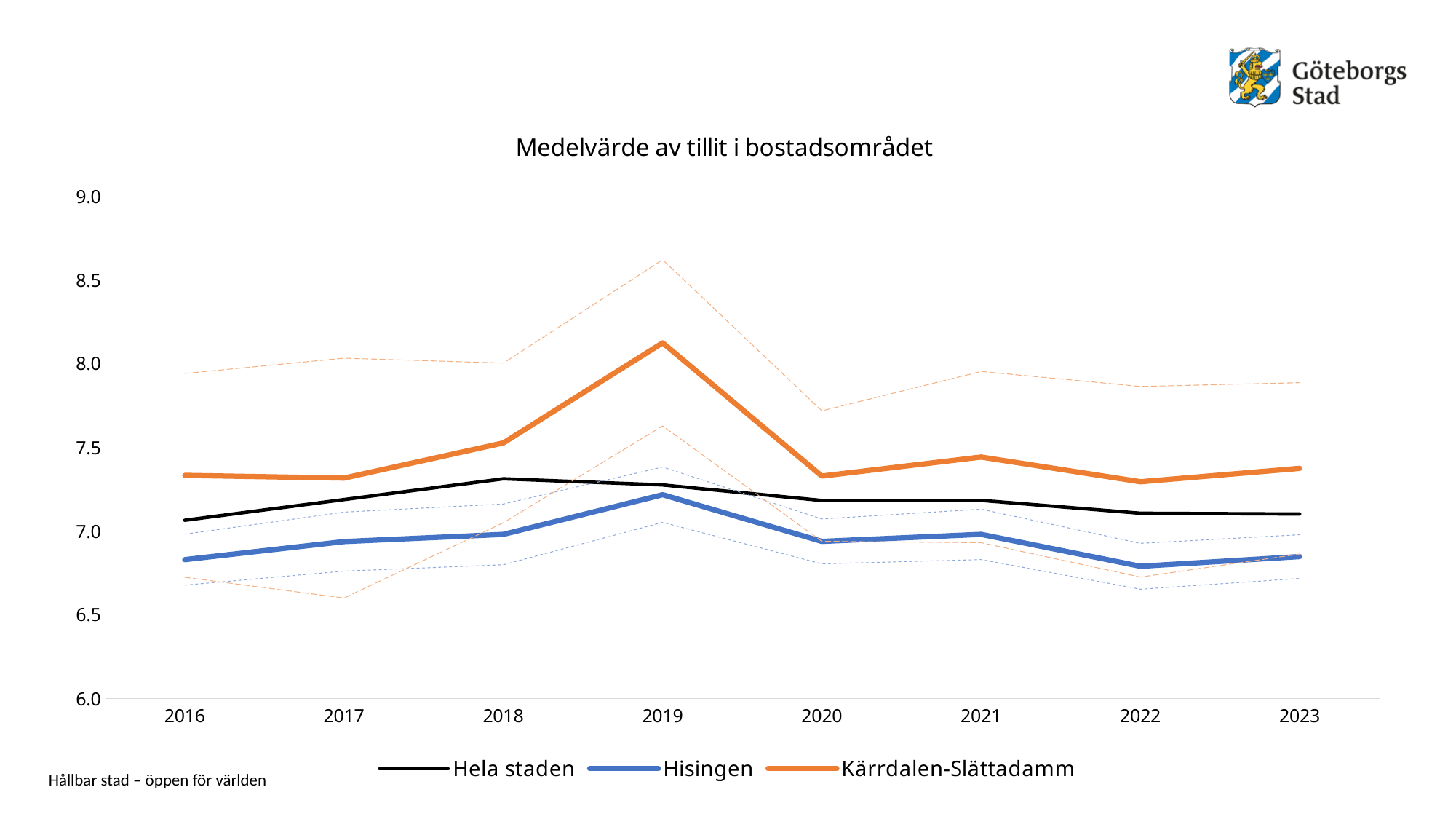
How many series does the legend list? 3 Does the value for Kärrdalen-Slättadamm rise or fall from 2019 to 2020? fall In which year does Hisingen reach its highest value? 2019 Is the value for Kärrdalen-Slättadamm in 2020 greater or less than 7.5? less How many years are shown on the x axis? 8 Is the value for Kärrdalen-Slättadamm in 2019 greater or less than 8.0? greater What kind of chart is shown on the slide? Line chart In which year does Kärrdalen-Slättadamm reach its highest value? 2019 Is the value for Hisingen in 2016 greater or less than 7.0? less Which series is drawn in orange? Kärrdalen-Slättadamm In 2016, which is larger: Hela staden or Hisingen? Hela staden What is the title of the chart? Medelvärde av tillit i bostadsområdet